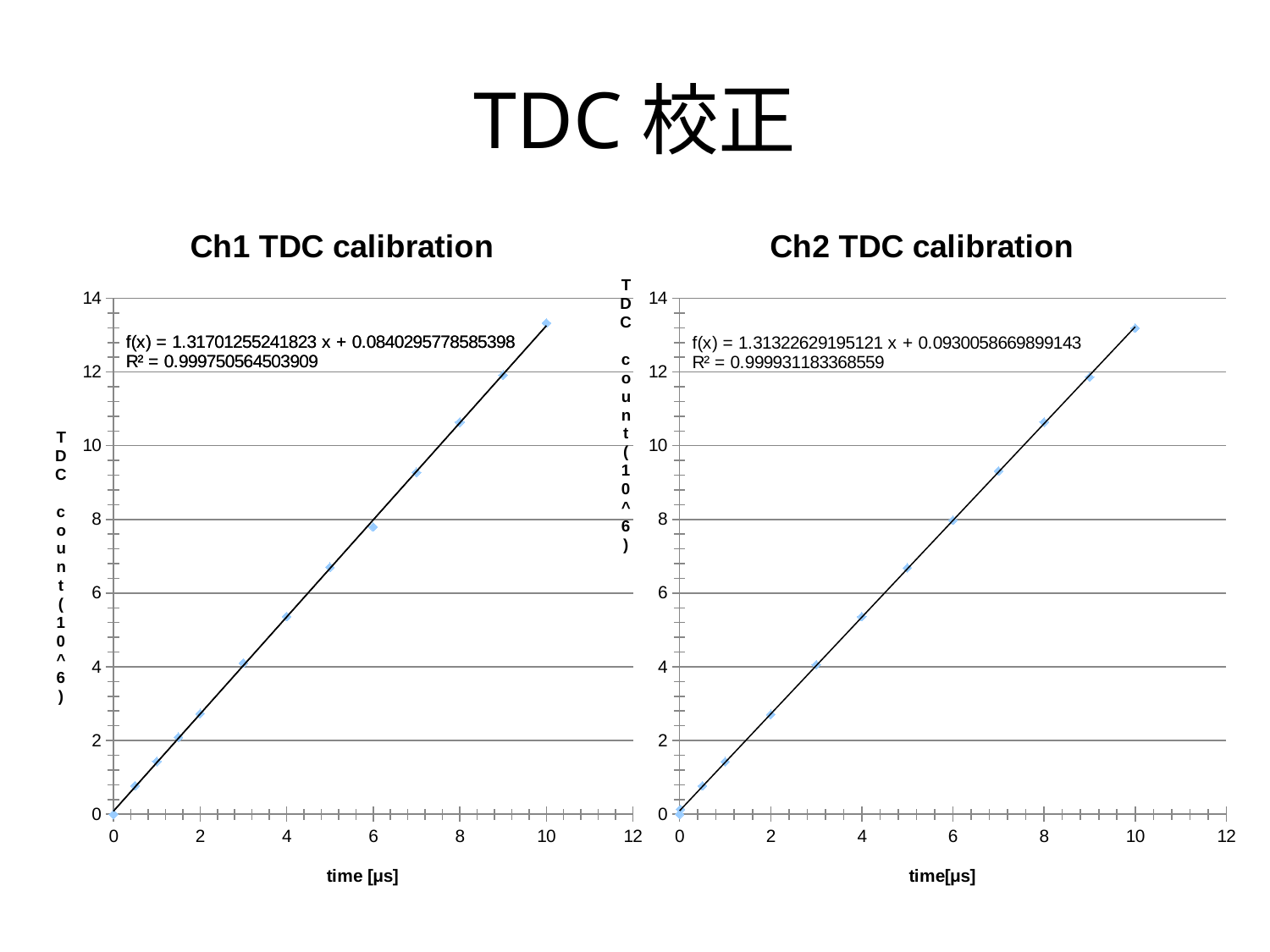
In the Ch1 TDC calibration chart, is the TDC count at time 10 µs greater or less than 12? greater What is the title of the chart on the left of the slide? Ch1 TDC calibration In the Ch2 TDC calibration chart, which time has the highest TDC count? 10 In the Ch2 TDC calibration chart, is the TDC count at time 2 µs greater or less than 4? less In the Ch2 TDC calibration chart, do the TDC count values rise or fall as time increases? rise In the Ch1 TDC calibration chart, which is larger, the TDC count at time 8 µs or at time 6 µs? time 8 µs In the Ch1 TDC calibration chart, is the TDC count at time 4 µs greater or less than 4? greater In the Ch1 TDC calibration chart, do the TDC count values rise or fall as time increases? rise What kind of chart is the Ch1 TDC calibration chart? scatter chart What R² value is shown on the Ch2 TDC calibration chart? 0.999931183368559